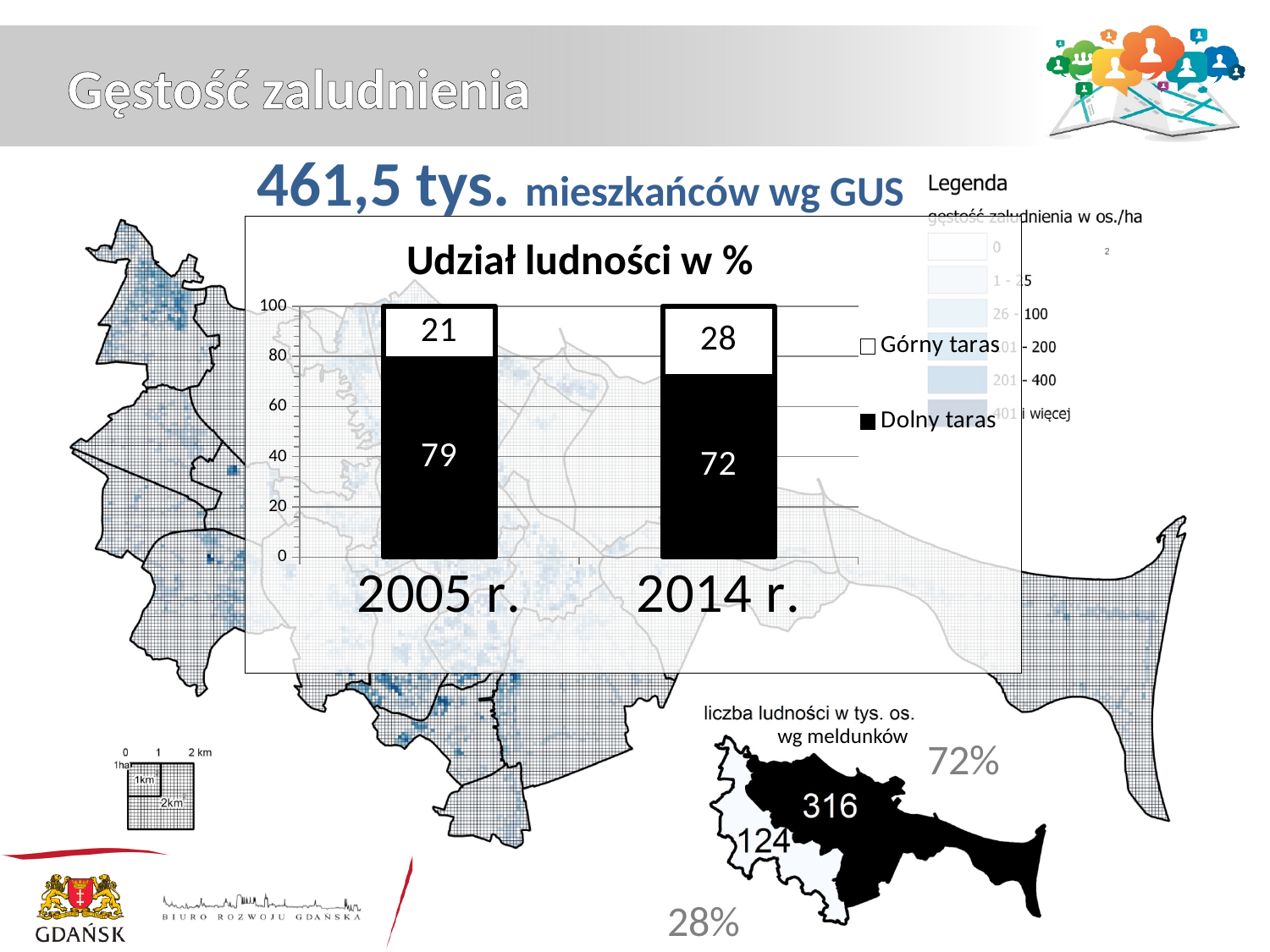
What is the value for Dolny taras in 2014 r.? 72 What is the difference between the Dolny taras values for 2005 r. and 2014 r.? 7 What is the value for Dolny taras in 2005 r.? 79 Which series is larger in 2014 r., Górny taras or Dolny taras? Dolny taras How many categories are shown on the x axis? 2 What is the value for Górny taras in 2005 r.? 21 What type of chart is shown on the slide? stacked bar chart What is the total of the stacked bar for 2014 r.? 100 Does the Górny taras value rise or fall from 2005 r. to 2014 r.? rise How many series does the legend list? 2 What is the value for Górny taras in 2014 r.? 28 What is the title of the chart? Udział ludności w %